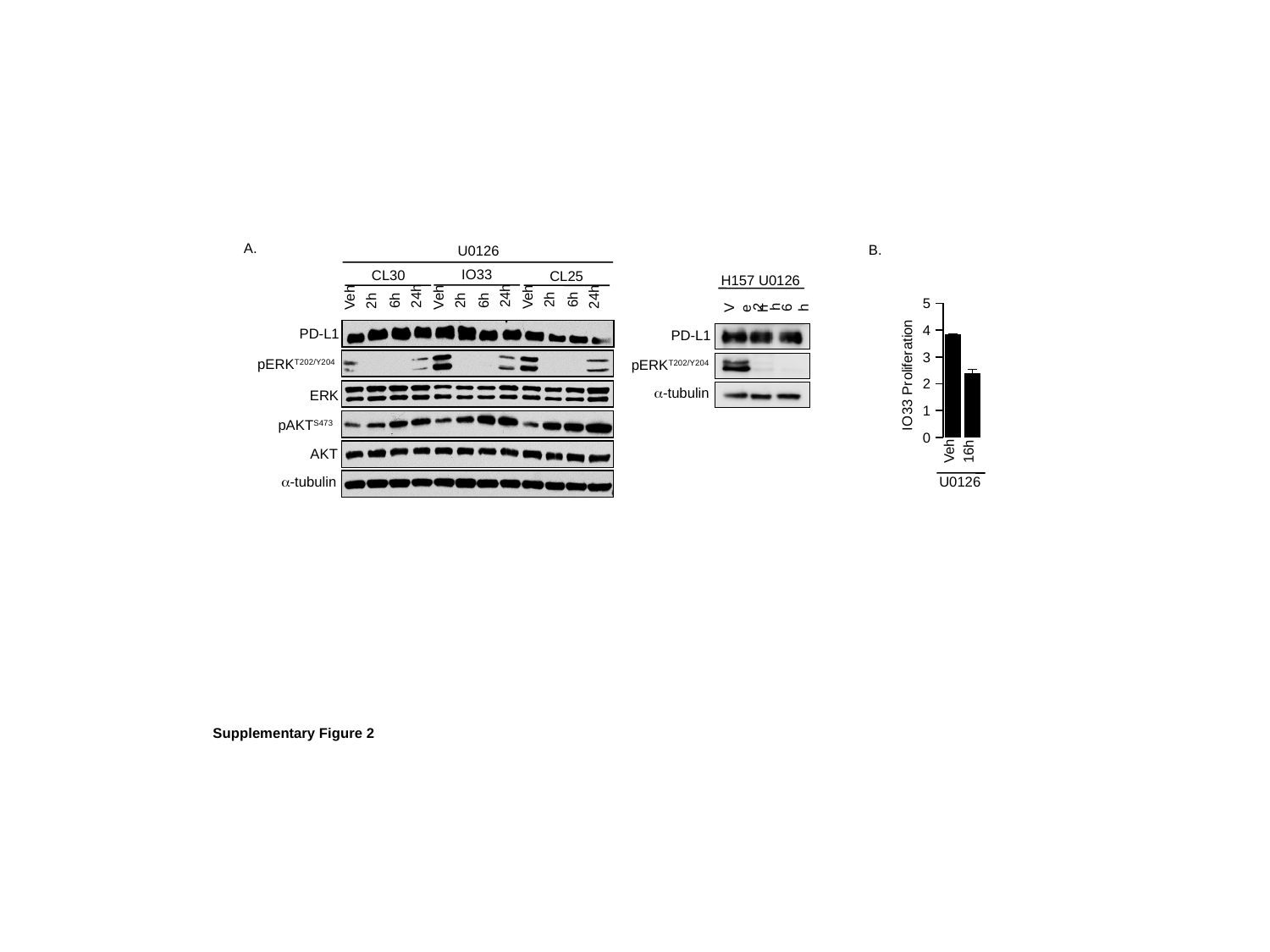
In the bar chart in panel B, what is the label on the y axis? IO33 Proliferation In the bar chart in panel B, is the value for 16h greater or less than 3? less In the bar chart in panel B, what kind of chart is shown? bar chart In the bar chart in panel B, is the value for Veh greater or less than 3? greater In the bar chart in panel B, which condition has the higher IO33 Proliferation value, Veh or 16h? Veh In the bar chart in panel B, what treatment label is written beneath the x-axis categories? U0126 In the bar chart in panel B, does the value fall or rise from Veh to 16h? fall In the bar chart in panel B, how many bars are plotted? 2 In the bar chart in panel B, is the value for 16h greater or less than 2? greater In the bar chart in panel B, which bar is the highest? Veh In the bar chart in panel B, which bar is the lowest? 16h